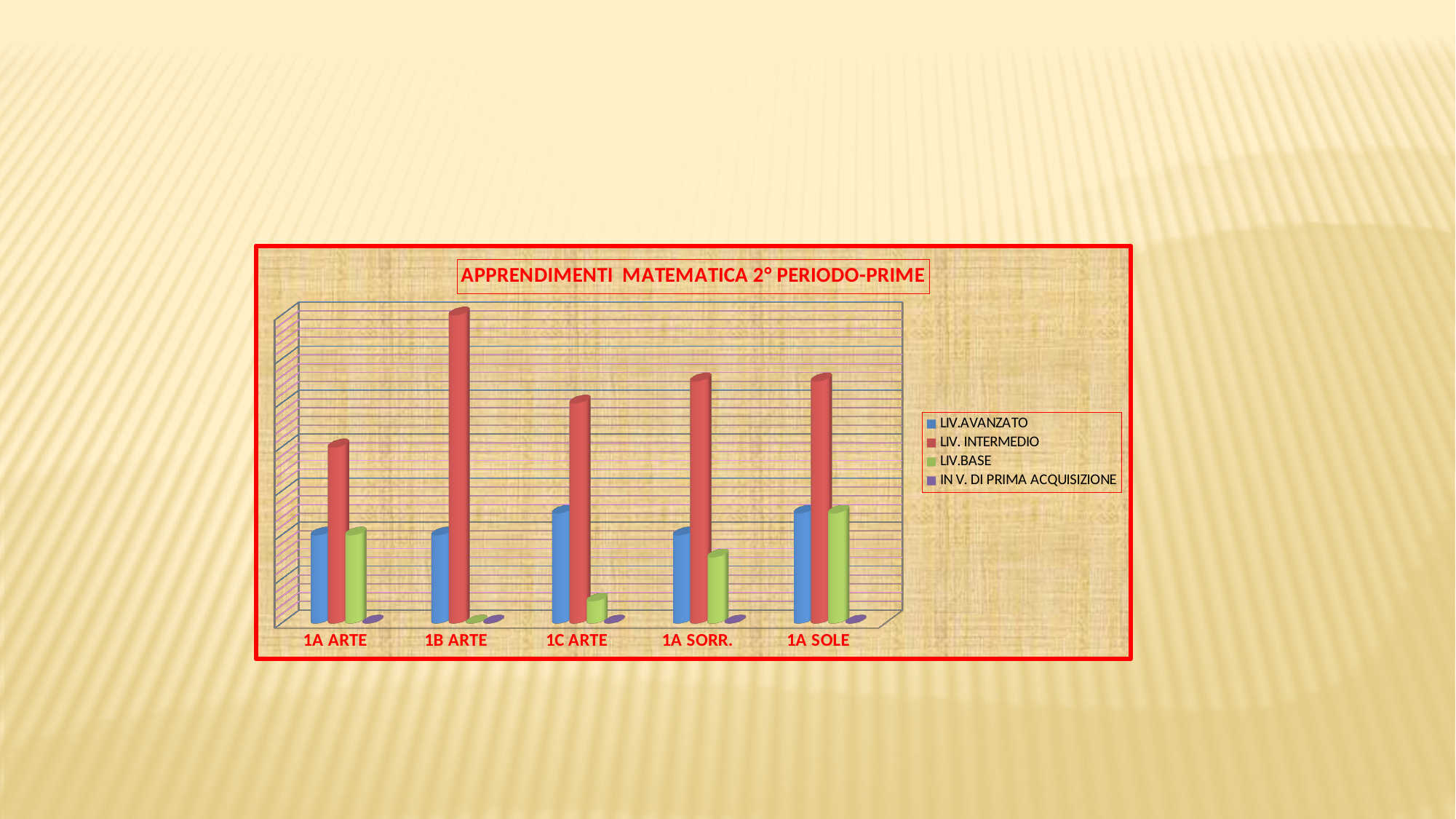
For 1A SOLE, which is larger, LIV.AVANZATO or LIV. INTERMEDIO? LIV. INTERMEDIO Which is larger, the LIV. INTERMEDIO value for 1A ARTE or for 1B ARTE? 1B ARTE Which class has the lowest LIV. INTERMEDIO value? 1A ARTE How many categories (classes) are shown on the x axis? 5 What kind of chart is shown on the slide? bar chart How many series does the legend list? 4 Which series is shown in red? LIV. INTERMEDIO What is the title of the chart? APPRENDIMENTI MATEMATICA 2° PERIODO-PRIME Which class has the highest LIV.BASE value? 1A SOLE Which class has the highest LIV. INTERMEDIO value? 1B ARTE Which class has the lowest LIV.BASE value? 1B ARTE Which is larger, the LIV.BASE value for 1C ARTE or for 1A SORR.? 1A SORR.